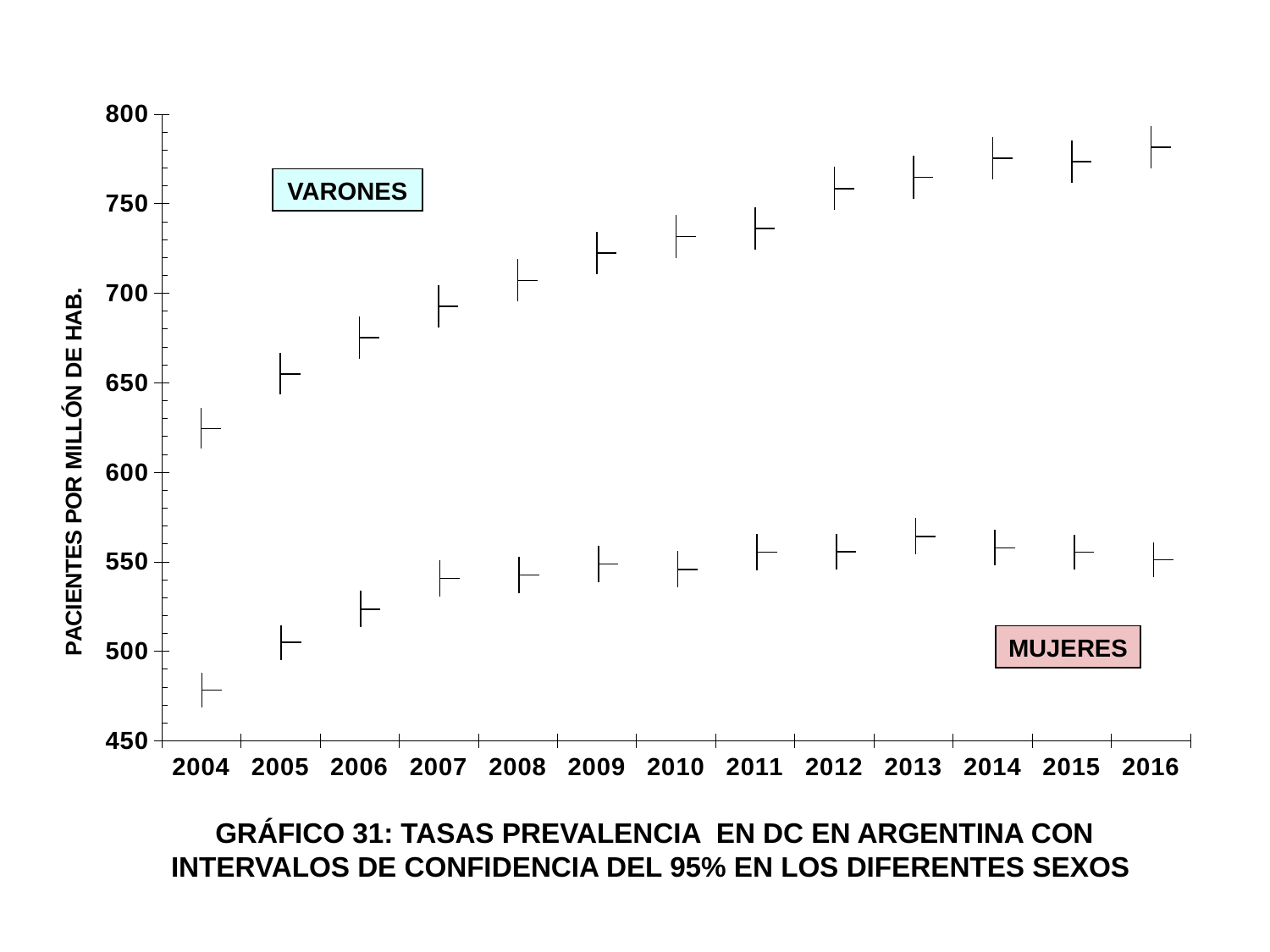
Is the value for MUJERES in 2004 greater or less than 500? less Is the value for VARONES in 2004 greater or less than 650? less Is the value for VARONES in 2010 greater or less than 700? greater In 2010, which series has the larger value, VARONES or MUJERES? VARONES How many years are shown on the x axis of the chart? 13 Do the values for VARONES rise or fall from 2004 to 2016? rise What is the label of the y axis? PACIENTES POR MILLÓN DE HAB. Which year has the lowest value for VARONES? 2004 Which year has the highest value for VARONES? 2016 Which year has the lowest value for MUJERES? 2004 How many series (sex groups) are plotted on the chart? 2